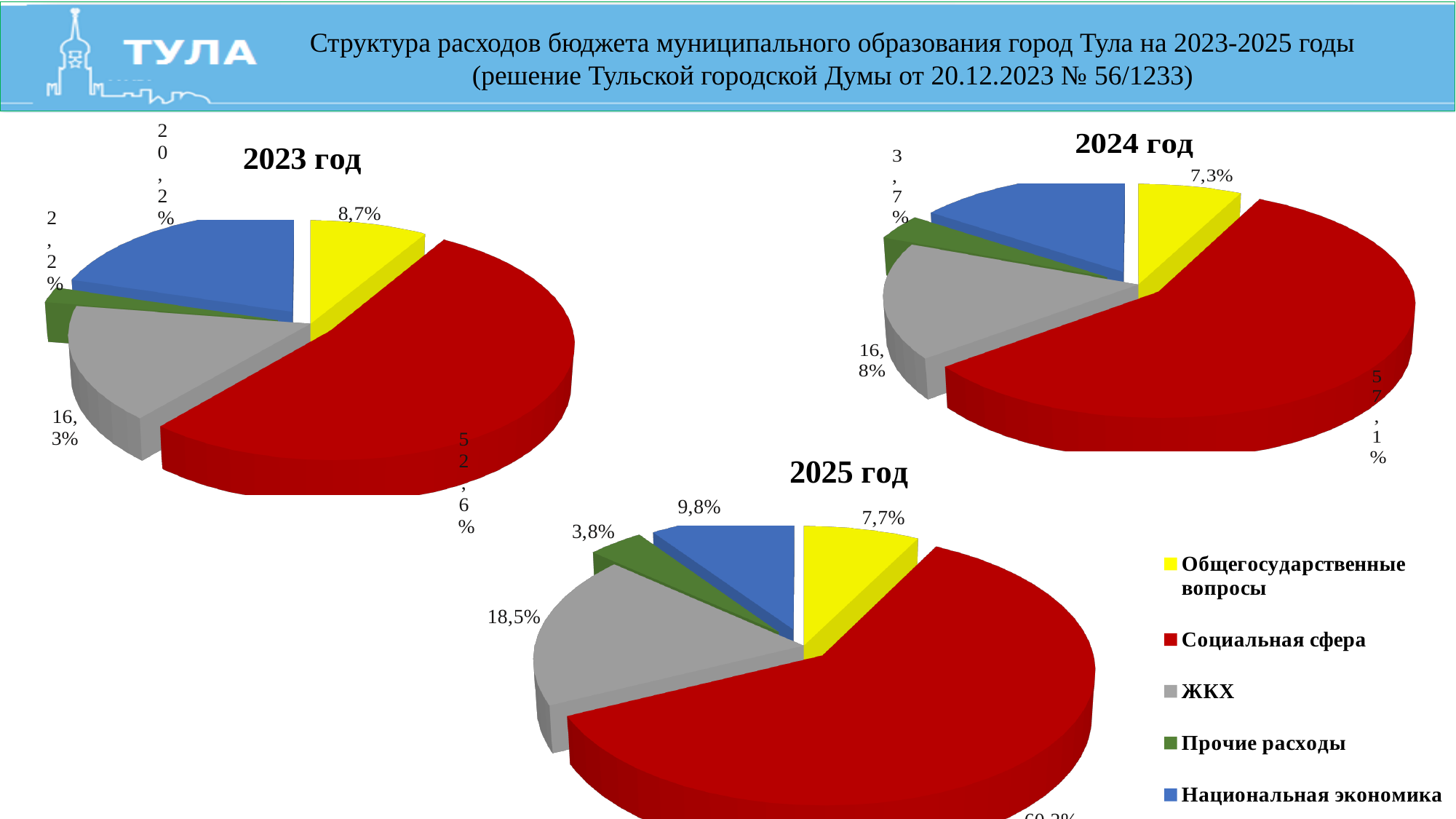
In the 2025 год chart, what share is shown for Национальная экономика? 9,8% In the 2023 год chart, which category has the smallest slice? Прочие расходы In the 2023 год chart, what share is shown for Социальная сфера? 52,6% In the 2023 год chart, what share is shown for Общегосударственные вопросы? 8,7% In the 2023 год chart, what share is shown for Национальная экономика? 20,2% In the 2024 год chart, what share is shown for ЖКХ? 16,8% In the 2025 год chart, which category has the largest slice? Социальная сфера In the 2025 год chart, what is the difference between the shares of ЖКХ and Общегосударственные вопросы? 10,8% In the 2024 год chart, what share is shown for Прочие расходы? 3,7% In the 2024 год chart, which is larger: the share of Общегосударственные вопросы or the share of ЖКХ? ЖКХ What type of chart is used for the 2024 год data? Pie chart How many categories does the legend list for the pie charts? 5